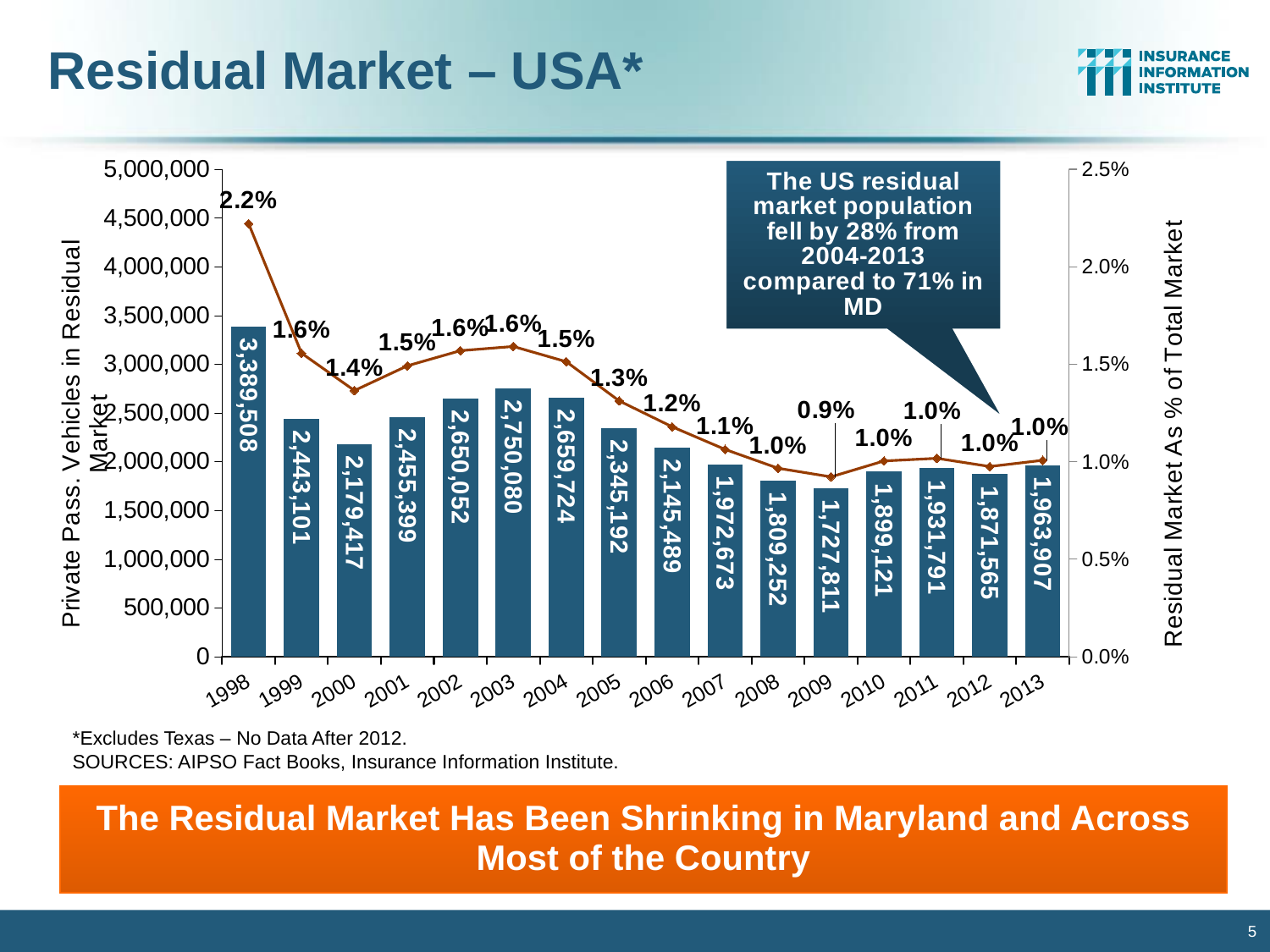
Which year has the lowest number of private passenger vehicles in the residual market? 2009 How many private passenger vehicles were in the residual market in 2013? 1,963,907 Does the residual market as a percentage of the total market generally rise or fall from 1998 to 2013? Fall Which year has the highest number of private passenger vehicles in the residual market? 1998 Which year had more private passenger vehicles in the residual market, 2003 or 2005? 2003 What is the label of the right-hand vertical axis? Residual Market As % of Total Market What kind of chart is shown on the slide? A combination bar and line chart By how much did the number of private passenger vehicles in the residual market fall from 2004 to 2013? 695,817 What was the residual market as a percentage of the total market in 2009? 0.9% How many years are shown on the x axis of the chart? 16 Is the number of private passenger vehicles in the residual market in 2000 greater or less than 2,500,000? less How many private passenger vehicles were in the residual market in 1998? 3,389,508